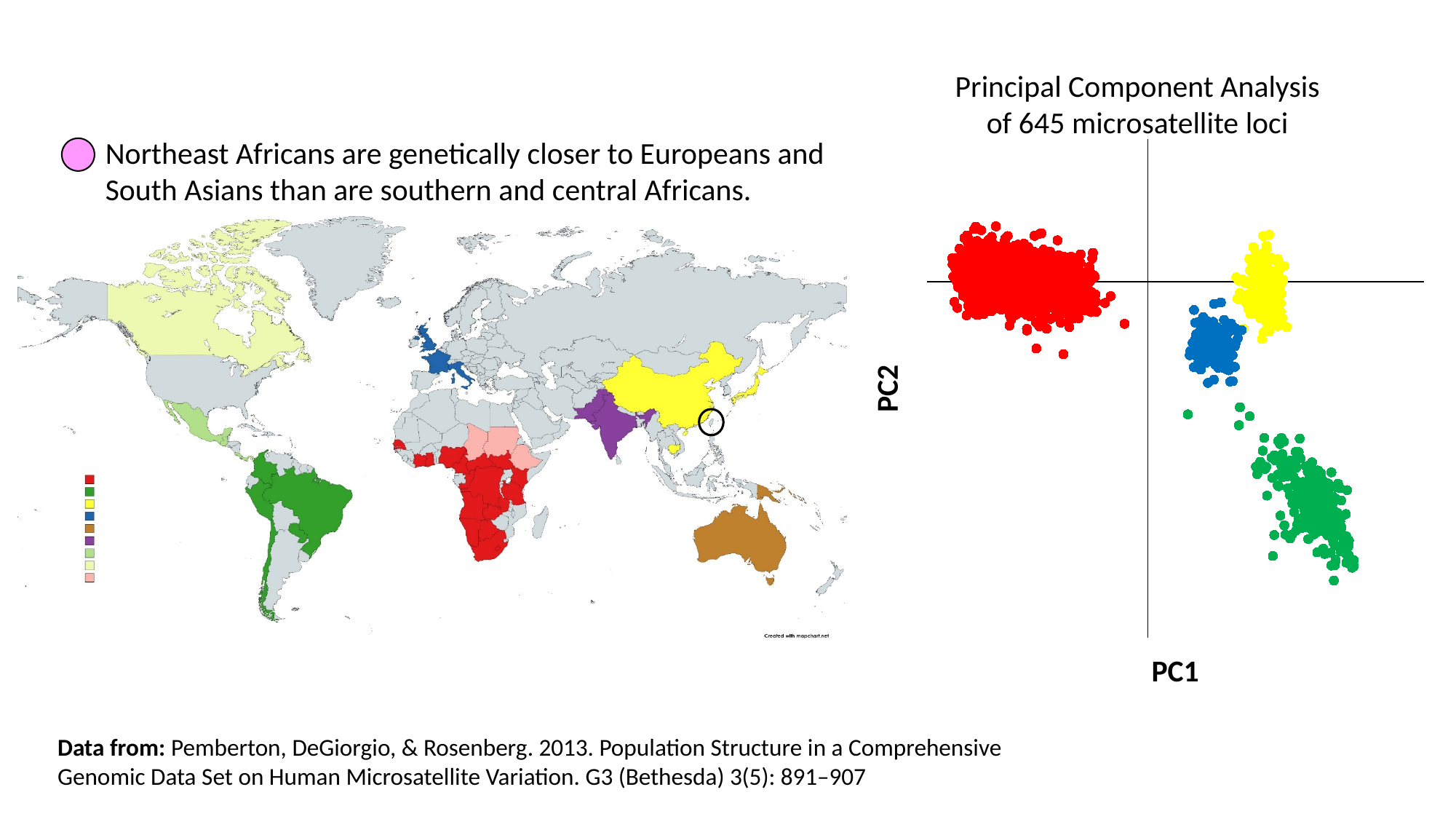
In the Principal Component Analysis chart, is the red cluster on the left or the right side of the vertical PC2 axis? left In the Principal Component Analysis chart, is the green cluster above or below the horizontal PC1 axis? below In the Principal Component Analysis chart, which cluster is further left on PC1: the red cluster or the blue cluster? red In the Principal Component Analysis chart, which coloured cluster lies furthest to the left along PC1? red What is the title of the chart on the right side of the slide? Principal Component Analysis of 645 microsatellite loci In the Principal Component Analysis chart, which coloured cluster lies lowest along PC2? green What kind of chart is shown on the right side of the slide? scatter chart In the Principal Component Analysis chart, which coloured cluster lies furthest to the right along PC1? green In the Principal Component Analysis chart, what is the label of the vertical axis? PC2 In the Principal Component Analysis chart, what is the label of the horizontal axis? PC1 How many differently coloured clusters of points are plotted in the Principal Component Analysis chart? 4